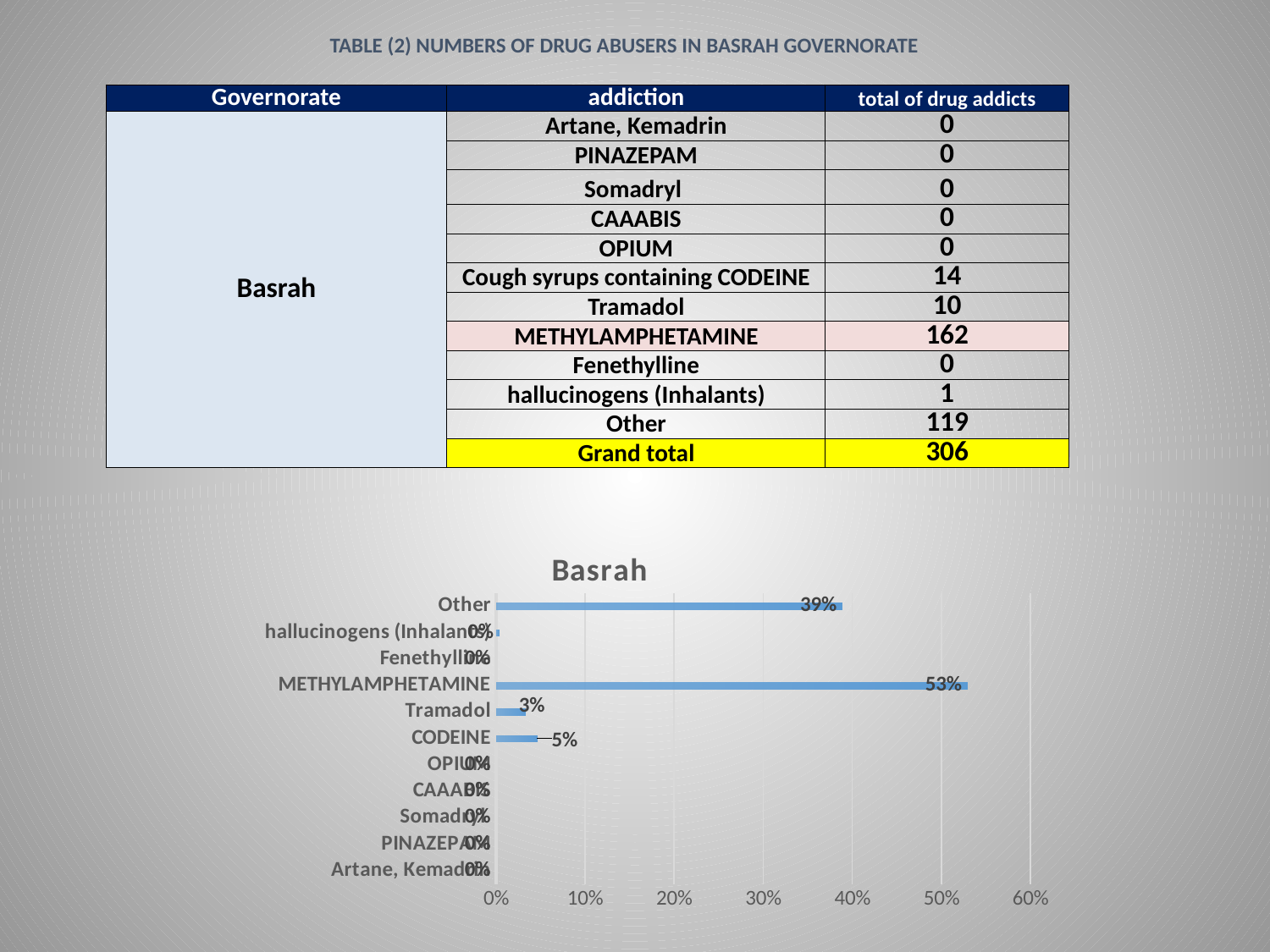
What is the difference between the values for METHYLAMPHETAMINE and Other in the chart? 14% How many categories are shown in the chart? 11 Is the value for METHYLAMPHETAMINE in the chart greater or less than 50%? greater What is the value for Other in the chart? 39% What type of chart is shown on the slide? bar chart Which is larger in the chart, the value for CODEINE or the value for Tramadol? CODEINE What is the title of the chart? Basrah What is the value for CODEINE in the chart? 5% What is the difference between the values for CODEINE and Tramadol in the chart? 2% What is the value for Tramadol in the chart? 3% What is the value for METHYLAMPHETAMINE in the chart? 53% Which category has the highest value in the chart? METHYLAMPHETAMINE